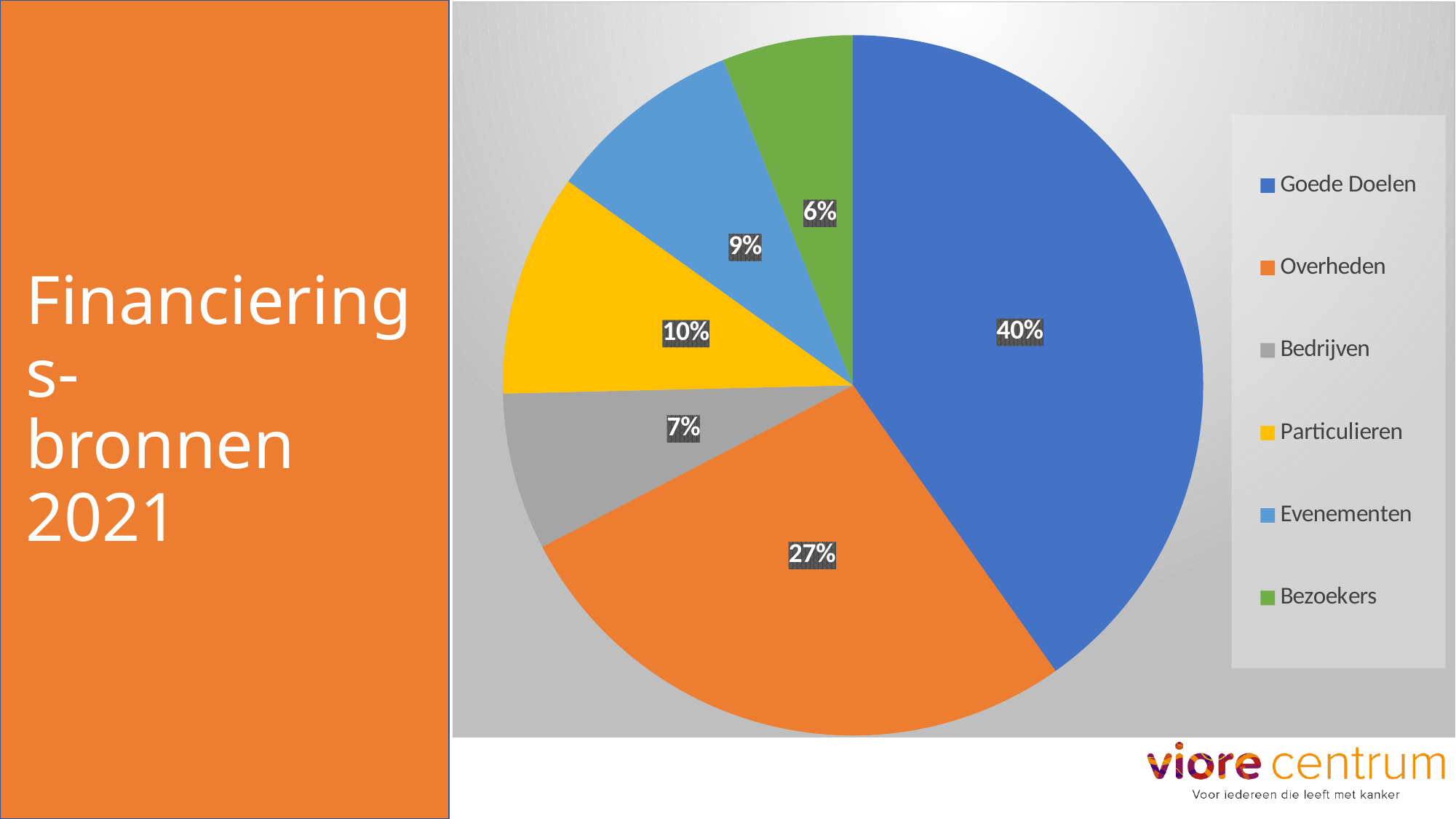
What kind of chart is shown on the slide? pie chart Which category has the largest slice of the pie? Goede Doelen What is the difference in percentage points between Goede Doelen and Overheden? 13 Which is larger, the share for Evenementen or the share for Bedrijven? Evenementen What share of the pie does Goede Doelen have? 40% What share of the pie does Overheden have? 27% How many categories does the pie chart have? 6 What share of the pie does Bezoekers have? 6% Which legend entry is listed third? Bedrijven What colour is the Particulieren slice? yellow Which category has the smallest slice of the pie? Bezoekers